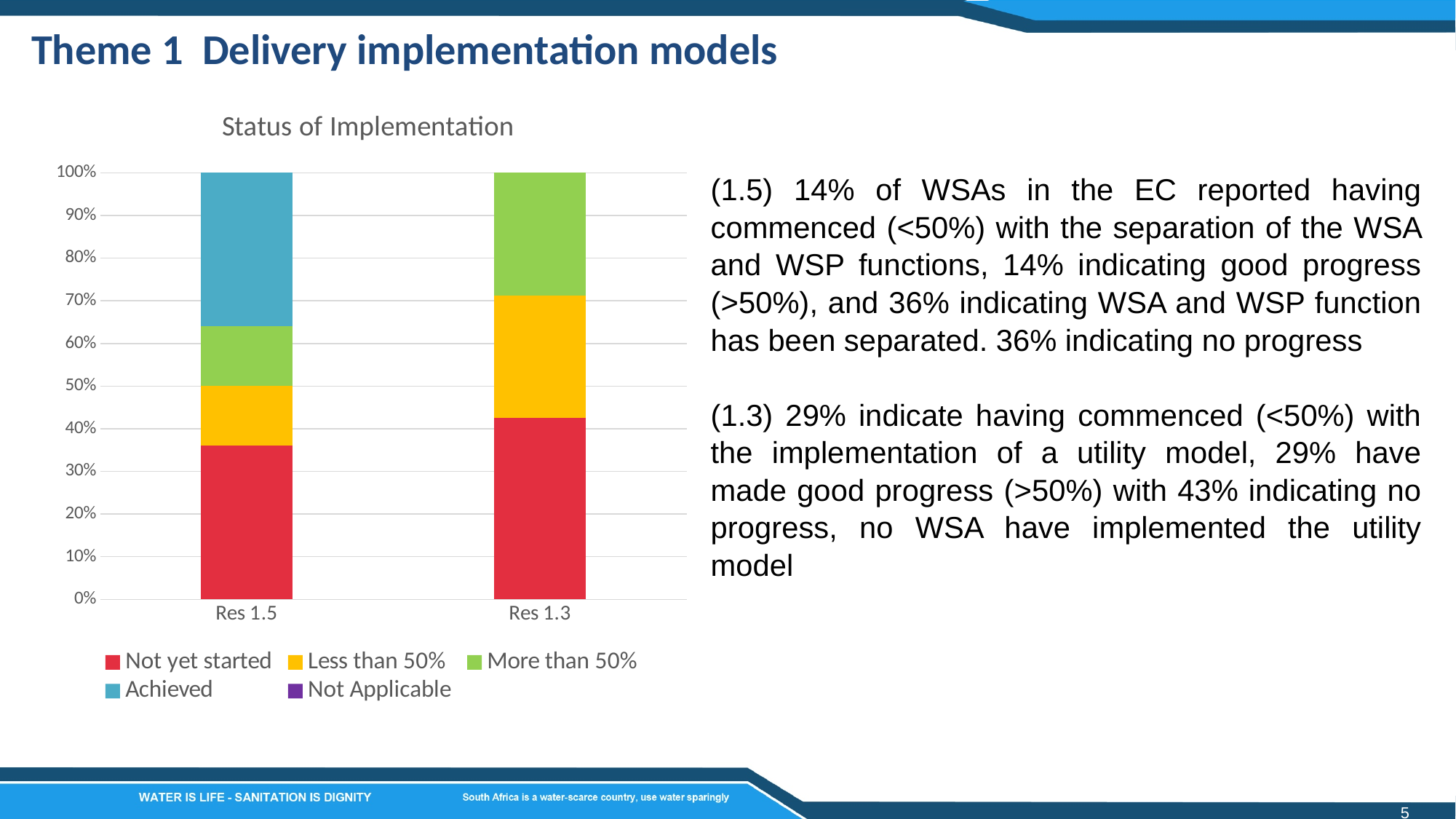
Is the Less than 50% value for Res 1.3 greater or less than 20%? greater What type of chart is shown on the slide? Stacked bar chart What is the total height of the stacked bar for Res 1.5? 100% Is the Not yet started value for Res 1.3 greater or less than 40%? greater How many series does the chart legend list? 5 How many categories are shown on the x axis of the chart? 2 Is the Not yet started value for Res 1.5 greater or less than 40%? less What is the title of the chart? Status of Implementation Which category has the larger Achieved value, Res 1.5 or Res 1.3? Res 1.5 Which category has no Achieved segment in its bar? Res 1.3 Which category has the larger Not yet started value, Res 1.5 or Res 1.3? Res 1.3